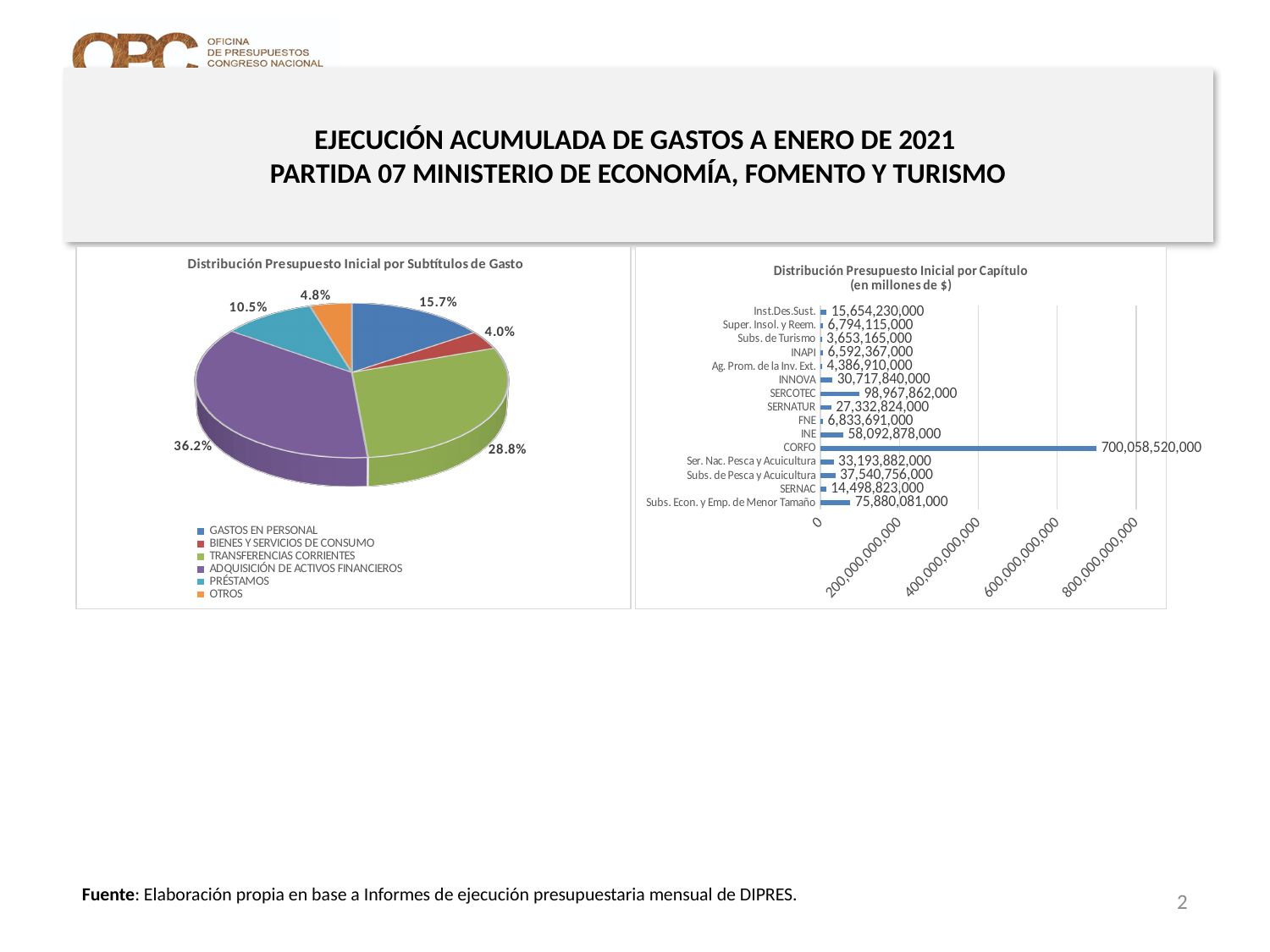
In the bar chart 'Distribución Presupuesto Inicial por Capítulo', what is the value for SERCOTEC? 98,967,862,000 In the pie chart 'Distribución Presupuesto Inicial por Subtítulos de Gasto', what share does TRANSFERENCIAS CORRIENTES have? 28.8% In the bar chart 'Distribución Presupuesto Inicial por Capítulo', which is larger, the value for INE or the value for INNOVA? INE In the bar chart 'Distribución Presupuesto Inicial por Capítulo', how many categories are plotted? 15 What kind of chart is the chart on the right of the slide? Bar chart In the bar chart 'Distribución Presupuesto Inicial por Capítulo', which category has the highest value? CORFO In the pie chart 'Distribución Presupuesto Inicial por Subtítulos de Gasto', which category has the smallest share? BIENES Y SERVICIOS DE CONSUMO In the bar chart 'Distribución Presupuesto Inicial por Capítulo', what is the value for CORFO? 700,058,520,000 In the pie chart 'Distribución Presupuesto Inicial por Subtítulos de Gasto', what is the difference between the shares of GASTOS EN PERSONAL and PRÉSTAMOS? 5.2% In the pie chart 'Distribución Presupuesto Inicial por Subtítulos de Gasto', how many categories does the legend list? 6 In the pie chart 'Distribución Presupuesto Inicial por Subtítulos de Gasto', what share does ADQUISICIÓN DE ACTIVOS FINANCIEROS have? 36.2% In the bar chart 'Distribución Presupuesto Inicial por Capítulo', which category has the lowest value? Subs. de Turismo